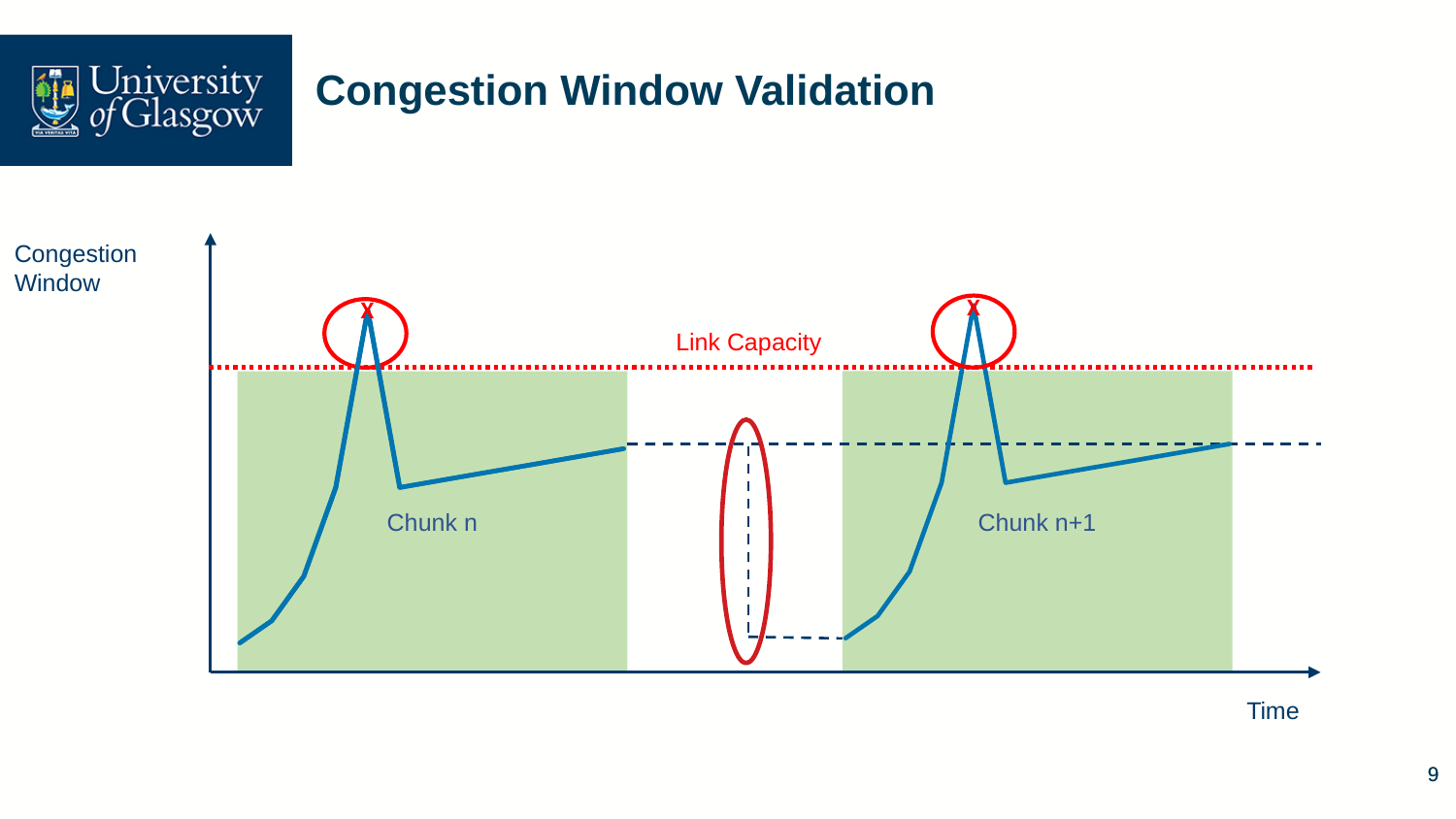
Immediately after the peak marked with an X in Chunk n, does the congestion window rise or fall? fall After the sharp drop in Chunk n, does the congestion window rise or fall towards the end of the chunk? rise Is the peak of the congestion window in Chunk n above or below the Link Capacity line? above Is the peak of the congestion window in Chunk n+1 above or below the Link Capacity line? above What is the title of the slide's chart? Congestion Window Validation What kind of chart is shown on the slide? line chart At the start of Chunk n, does the congestion window rise or fall over time? rise Is the congestion window at the start of Chunk n+1 higher or lower than at the end of Chunk n? lower What label is given to the red dotted horizontal line in the chart? Link Capacity How many chunks are labelled in the chart? 2